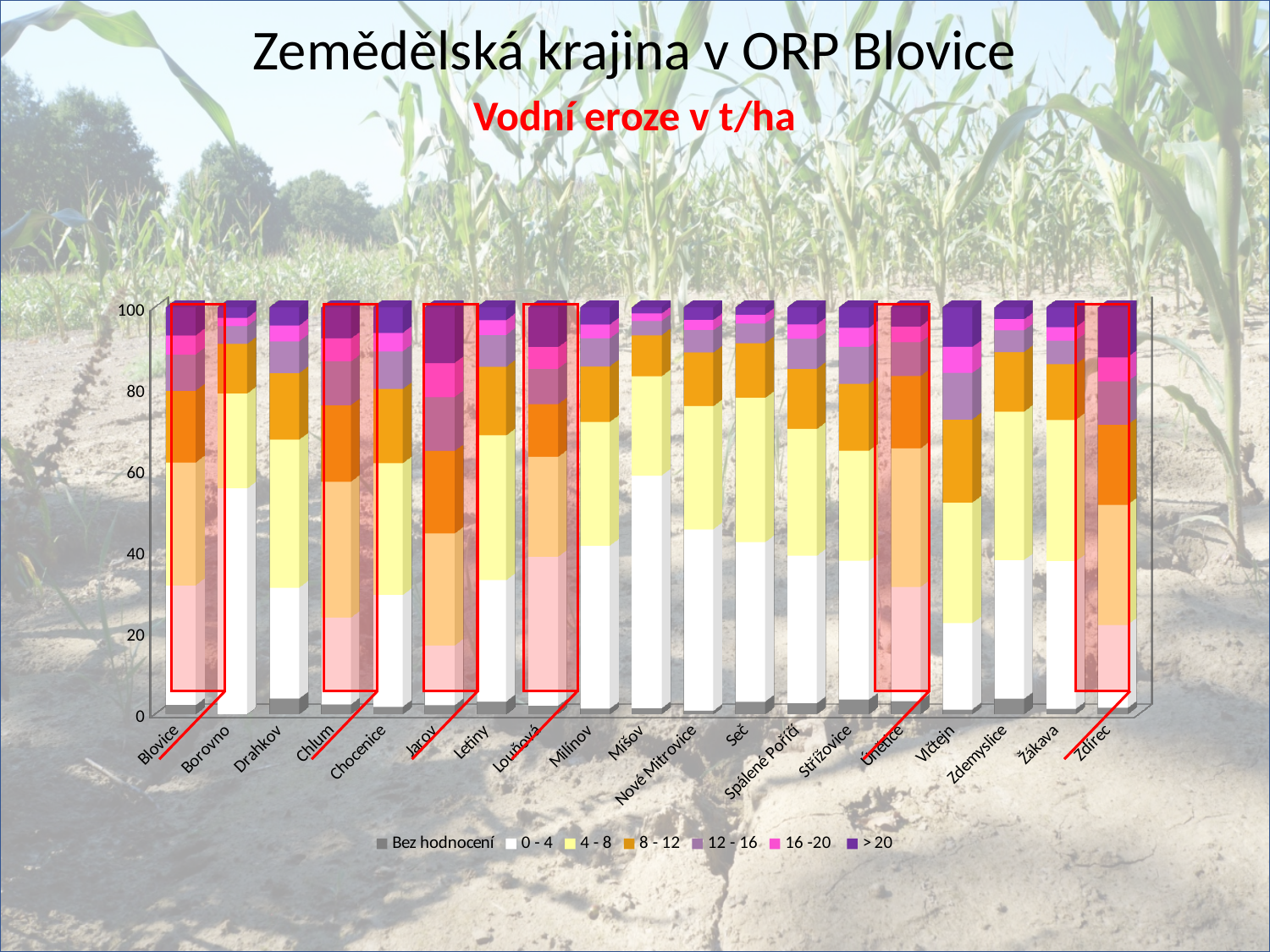
How many categories (municipalities) are shown on the x axis of the chart? 19 How many series does the chart legend list? 7 Is the '0 - 4' segment for Jarov greater or less than 20? less How many categories are highlighted with red rectangles on the chart? 6 Which has a larger '0 - 4' segment, Borovno or Blovice? Borovno What is the title of the chart? Vodní eroze v t/ha Is the '0 - 4' segment for Borovno greater or less than 60? less Is the '0 - 4' segment for Blovice greater or less than 20? greater Which category has the largest '0 - 4' segment in the chart? Míšov What value does the top of each stacked bar reach on the vertical axis? 100 What kind of chart is shown on the slide? Stacked bar chart